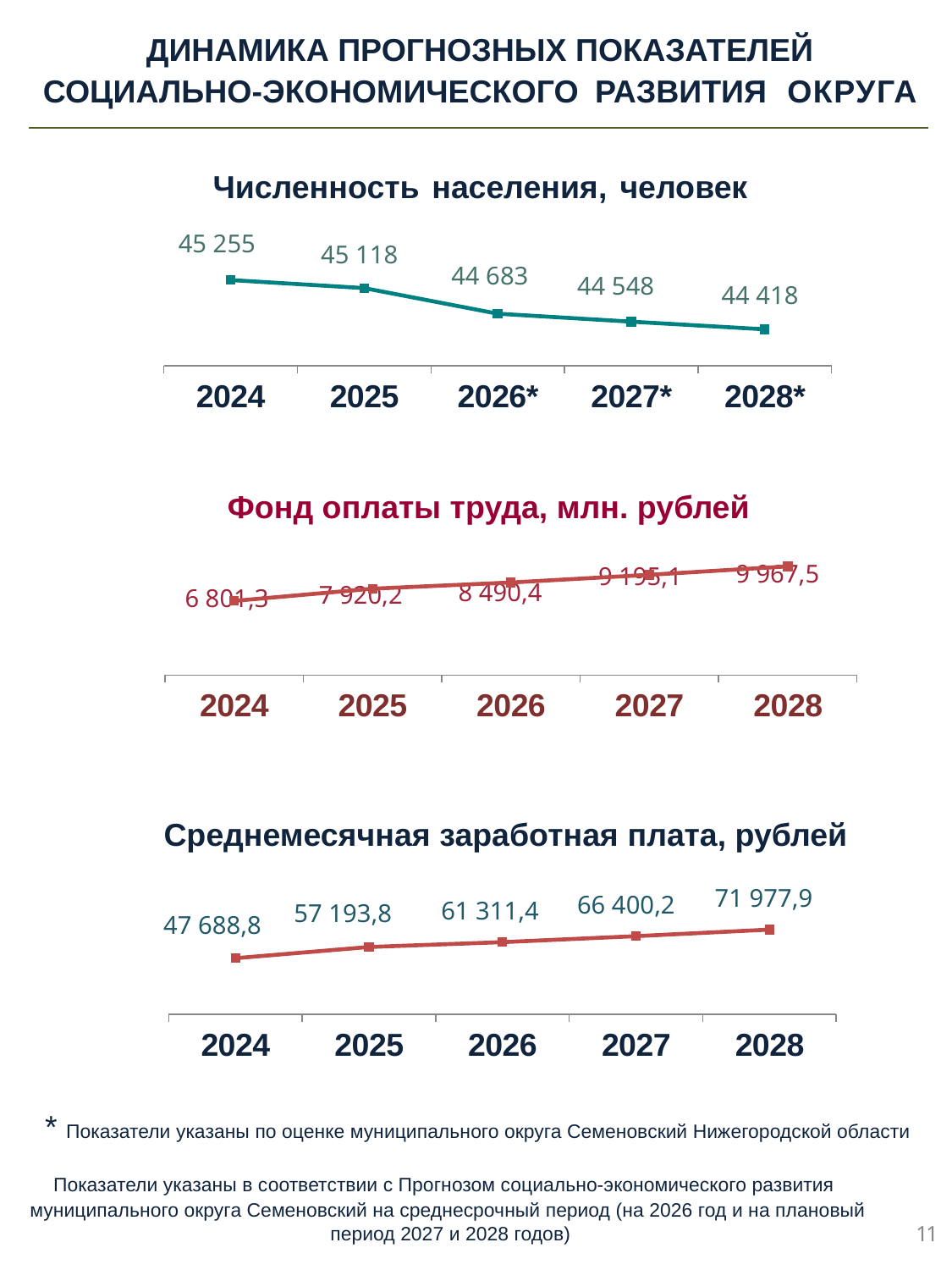
In the chart 'Среднемесячная заработная плата, рублей', what is the value for 2027? 66 400,2 In the chart 'Среднемесячная заработная плата, рублей', how many years are plotted? 5 In the chart 'Численность населения, человек', which year has the lowest value? 2028* In the chart 'Численность населения, человек', do the values rise or fall from 2024 to 2028*? fall What kind of chart is 'Среднемесячная заработная плата, рублей'? line chart In the chart 'Среднемесячная заработная плата, рублей', which is larger, the value for 2025 or the value for 2026? 2026 In the chart 'Численность населения, человек', what is the value for 2024? 45 255 In the chart 'Фонд оплаты труда, млн. рублей', what is the value for 2026? 8 490,4 In the chart 'Численность населения, человек', what is the difference between the 2024 and 2028* values? 837 In the chart 'Фонд оплаты труда, млн. рублей', which year has the highest value? 2028 In the chart 'Численность населения, человек', what is the value for 2028*? 44 418 In the chart 'Фонд оплаты труда, млн. рублей', what is the difference between the 2025 and 2024 values? 1 118,9